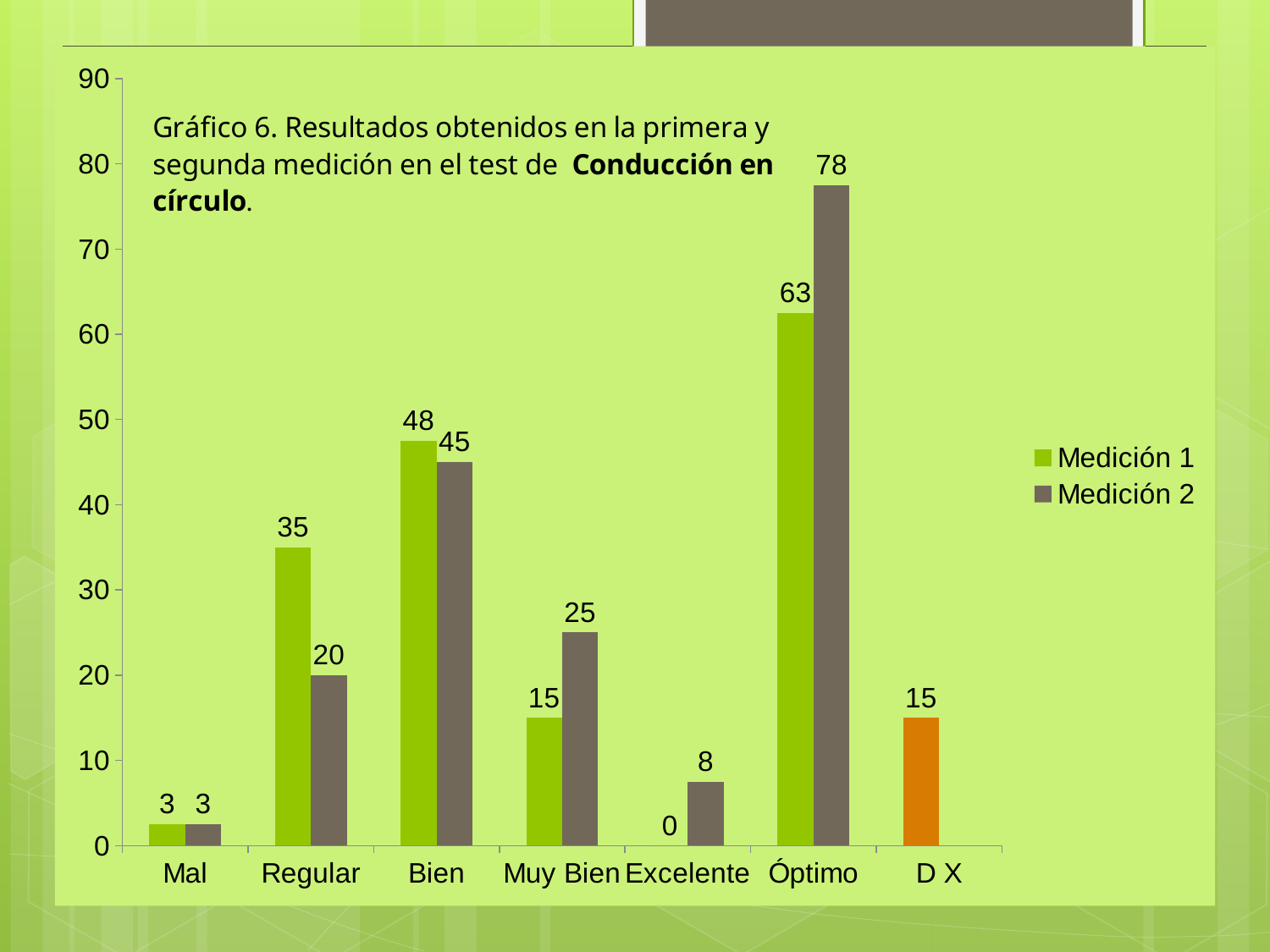
What is the value of Medición 2 for Óptimo? 78 How many series does the legend list? 2 Which is larger for Muy Bien, Medición 1 or Medición 2? Medición 2 What type of chart is shown on the slide? bar chart What is the value shown for D X? 15 What is the value of Medición 1 for Excelente? 0 Which category has the highest value for Medición 1? Óptimo How many categories are shown on the x axis? 7 Which category has the lowest value for Medición 2? Mal What is the value of Medición 1 for Regular? 35 What is the difference between Medición 2 and Medición 1 for Óptimo? 15 What is the value of Medición 2 for Excelente? 8